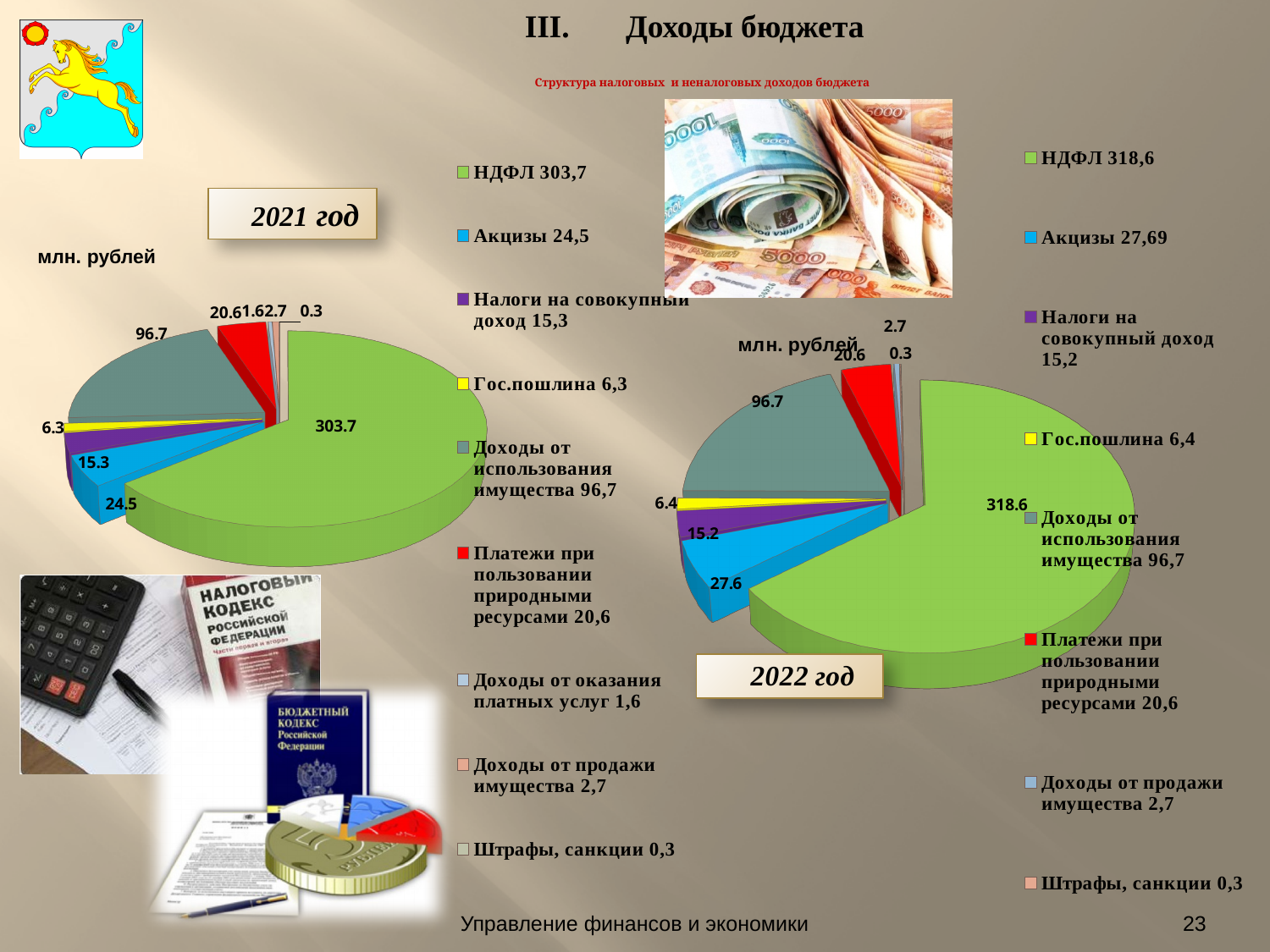
In the 2021 год chart, what is the value for НДФЛ? 303,7 In the 2021 год chart, which category has the largest value? НДФЛ In the 2021 год chart, what is the difference between Доходы от использования имущества and Акцизы? 72,2 In what units are the values of the two pie charts given? млн. рублей In the 2022 год chart, what is the value for Налоги на совокупный доход? 15,2 By how much is НДФЛ in the 2022 год chart larger than НДФЛ in the 2021 год chart? 14,9 In the 2021 год chart, which category has the smallest value? Штрафы, санкции What kind of chart is used for the 2021 год chart? pie chart In the 2021 год chart, which is larger: Акцизы or Доходы от использования имущества? Доходы от использования имущества How many categories does the 2021 год chart show? 9 In the 2022 год chart, what is the value for Гос.пошлина? 6,4 How many categories does the 2022 год chart show? 8